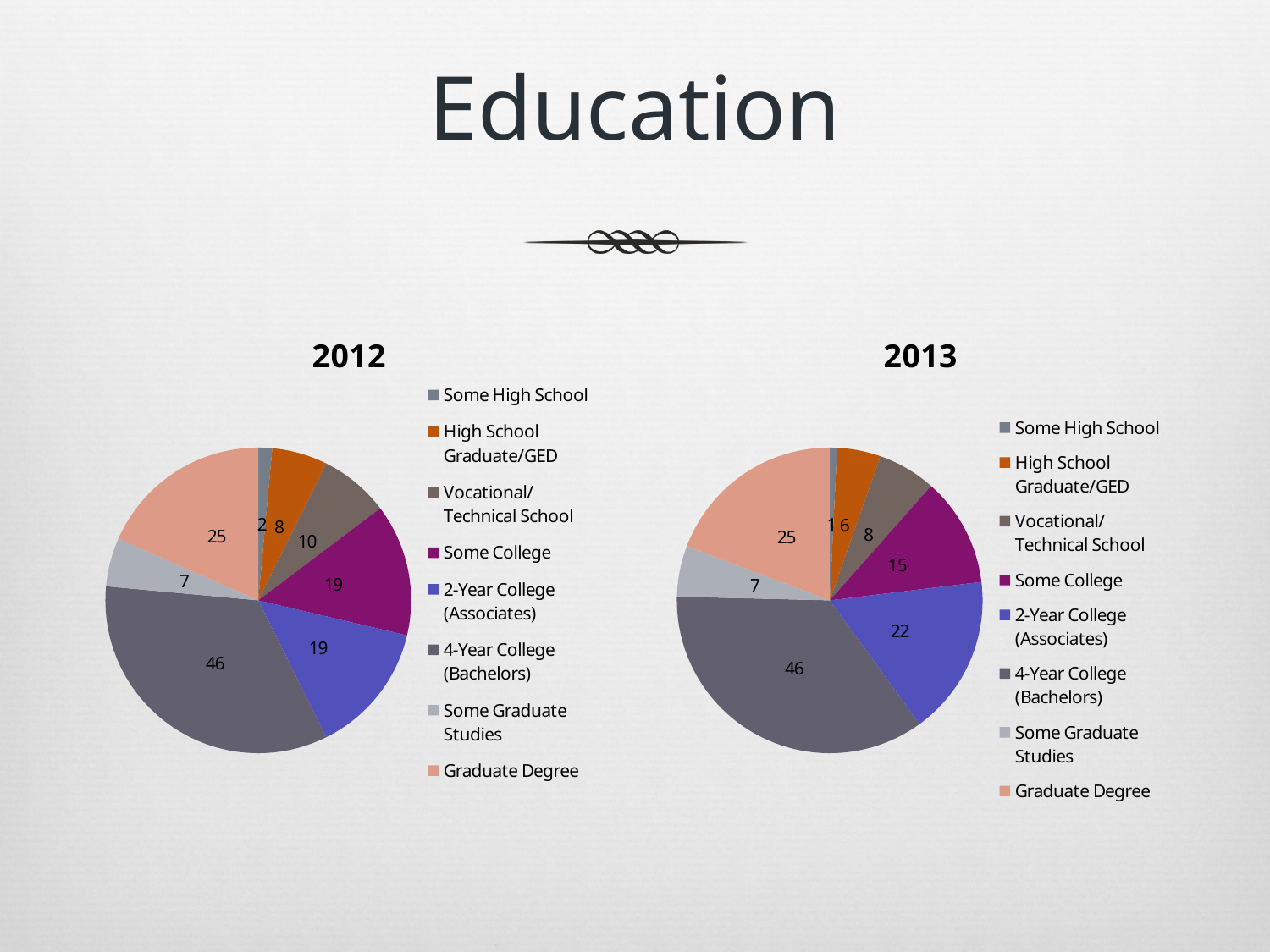
In the 2013 chart, what colour is the 4-Year College (Bachelors) slice? Dark grey What is the difference between the 2-Year College (Associates) value in the 2013 chart and in the 2012 chart? 3 In the 2013 chart, which is larger: Some College or High School Graduate/GED? Some College In the 2013 chart, what is the value for 2-Year College (Associates)? 22 In the 2012 chart, what is the difference between the Graduate Degree value and the Some Graduate Studies value? 18 What type of chart is the 2012 chart? Pie chart In the 2012 chart, which category has the largest value? 4-Year College (Bachelors) In the 2012 chart, what is the value for 4-Year College (Bachelors)? 46 In the 2013 chart, what is the value for Some College? 15 In the 2012 chart, what is the value for Vocational/Technical School? 10 How many categories does the 2013 chart's legend list? 8 In the 2013 chart, which category has the smallest value? Some High School